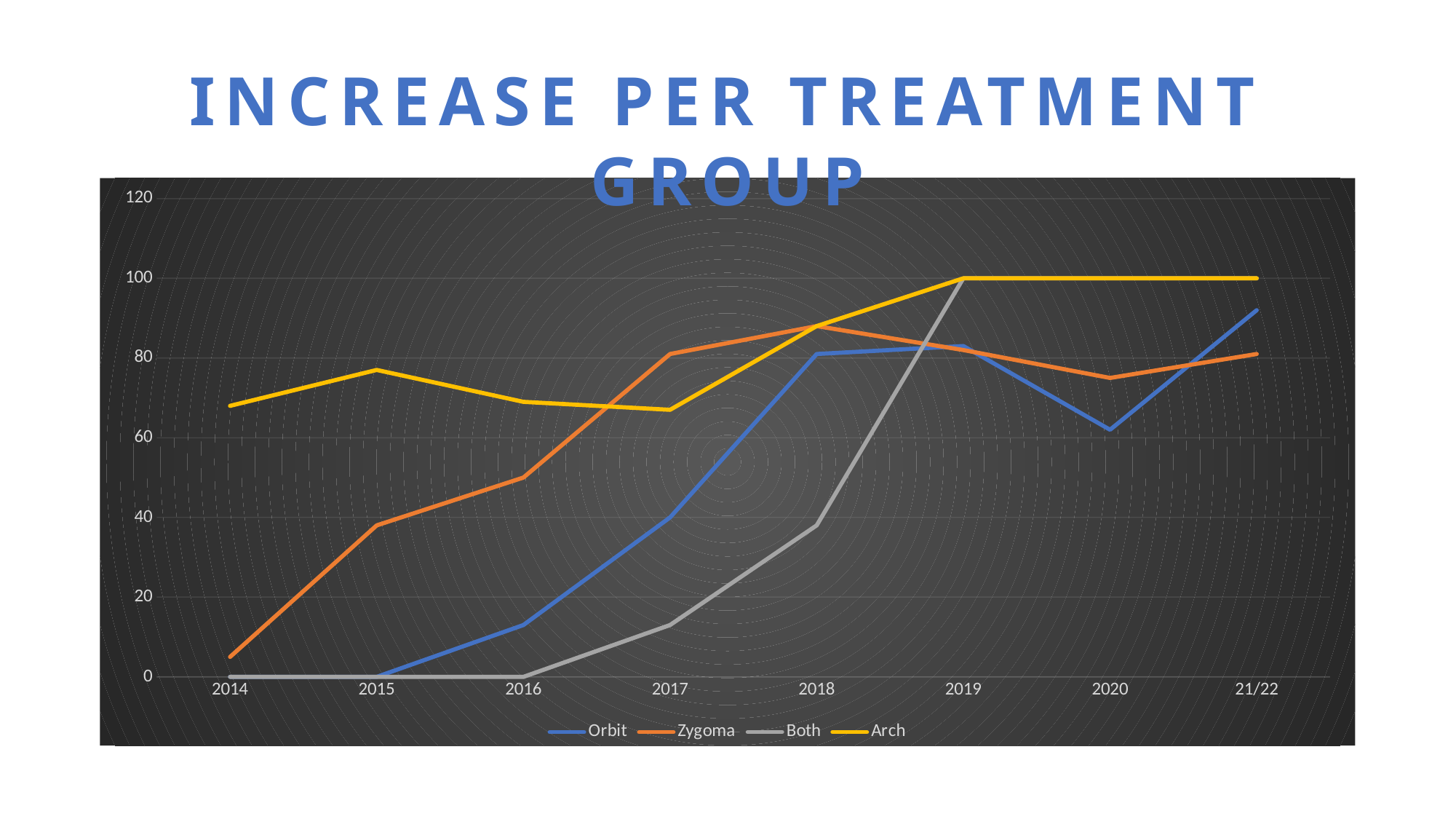
Is the value for Orbit in 2020 greater or less than 80? less Is the value for Zygoma in 2017 greater or less than 60? greater Which series has the highest value in 2015? Arch How many series does the legend list? 4 Which series has the lowest value in 2017? Both What is the value for Orbit in 2014? 0 What is the value for Arch in 2020? 100 Which series has the higher value in 2016, Zygoma or Orbit? Zygoma Does the Zygoma line rise or fall from 2014 to 2018? rise Is the value for Both in 2018 greater or less than 60? less What kind of chart is shown on the slide? line chart How many years are shown along the x axis? 8